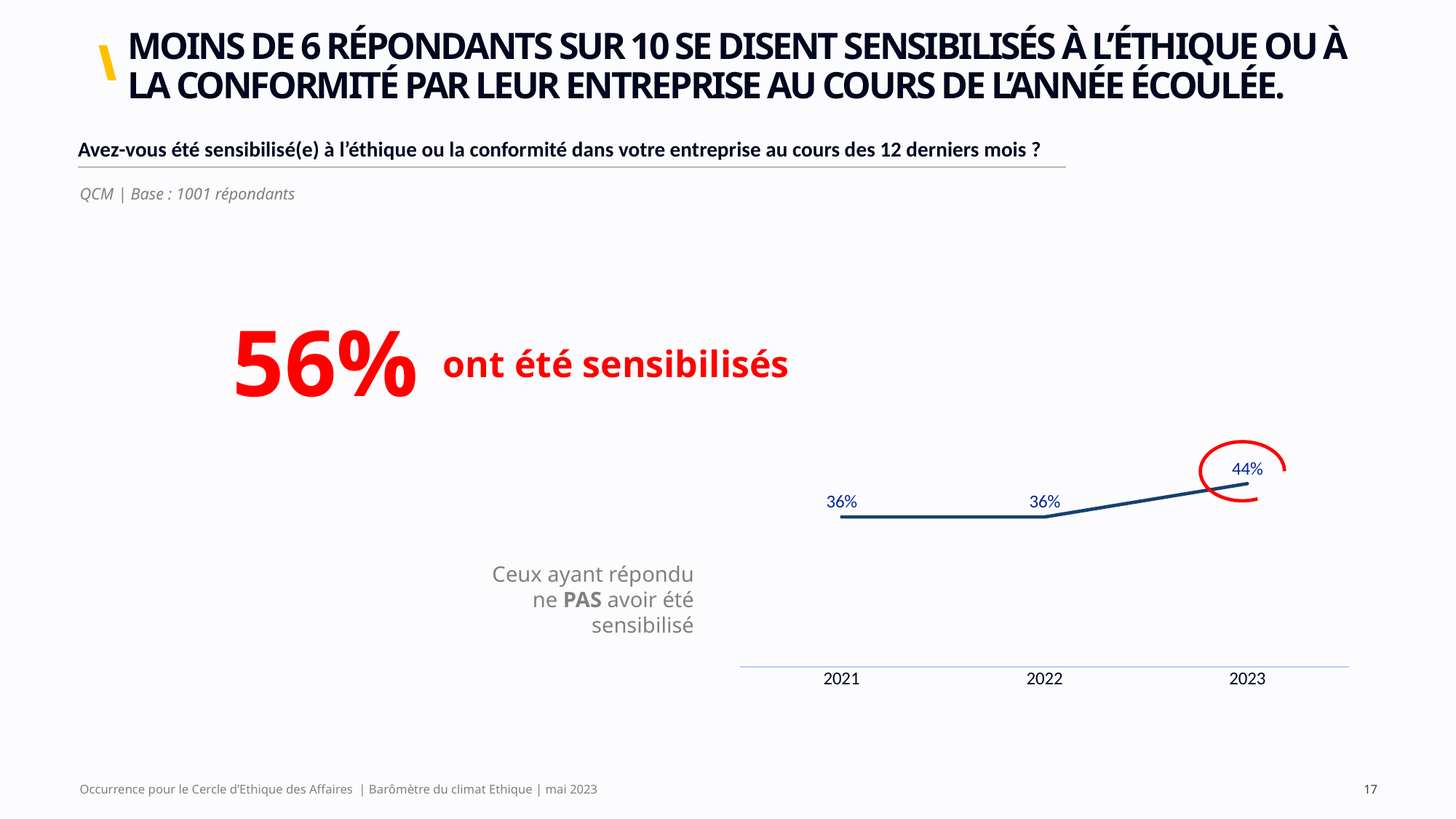
How many years are plotted on the x axis of the line chart? 3 Which year's data point is circled in red on the line chart? 2023 What is the difference between the 2023 value and the 2022 value in the line chart? 8% Which year has the highest value in the line chart? 2023 What kind of chart is shown on the slide? line chart What is the value for 2022 in the line chart? 36% What percentage of respondents say they have been sensitised ("ont été sensibilisés"), according to the large figure on the slide? 56% Is the value for 2023 larger or smaller than the value for 2021? larger What is the value for 2021 in the line chart? 36% What is the value for 2023 in the line chart? 44% What does the line chart represent, according to the label to its left? Ceux ayant répondu ne PAS avoir été sensibilisé Do the values in the line chart rise or fall from 2022 to 2023? rise